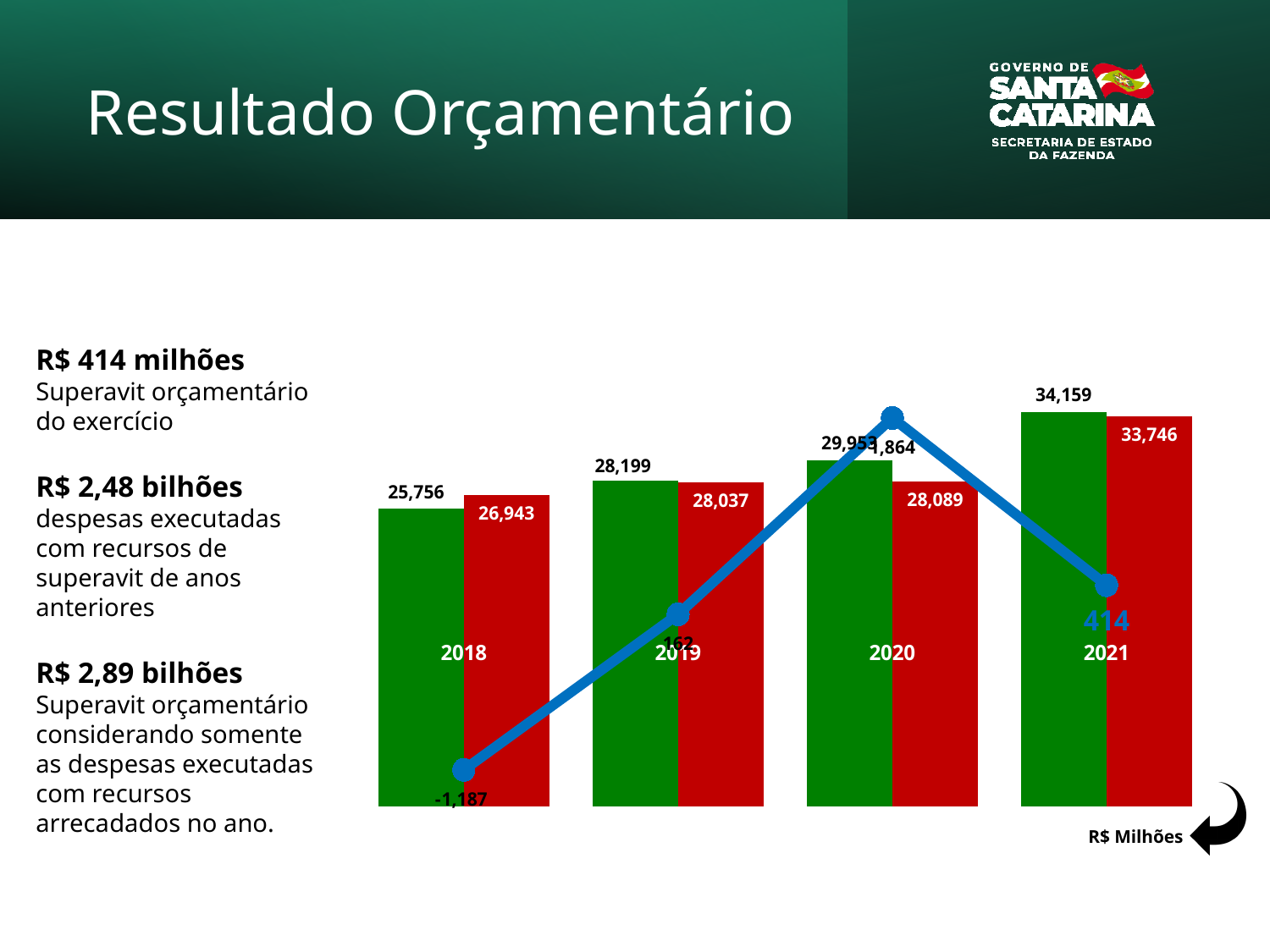
What unit is indicated at the bottom right of the chart? R$ Milhões In which year is the red bar the lowest? 2018 What value does the blue line show for 2021? 414 Do the green bars rise or fall from 2018 to 2021? Rise What is the value of the green bar for 2021? 34,159 How many years are shown on the x axis of the chart? 4 In 2018, which is larger: the green bar or the red bar? The red bar What is the difference between the red bar for 2021 and the red bar for 2020? 5,657 What is the difference between the green bar for 2021 and the green bar for 2018? 8,403 In which year is the green bar the highest? 2021 What value does the blue line show for 2018? -1,187 What is the value of the red bar for 2018? 26,943